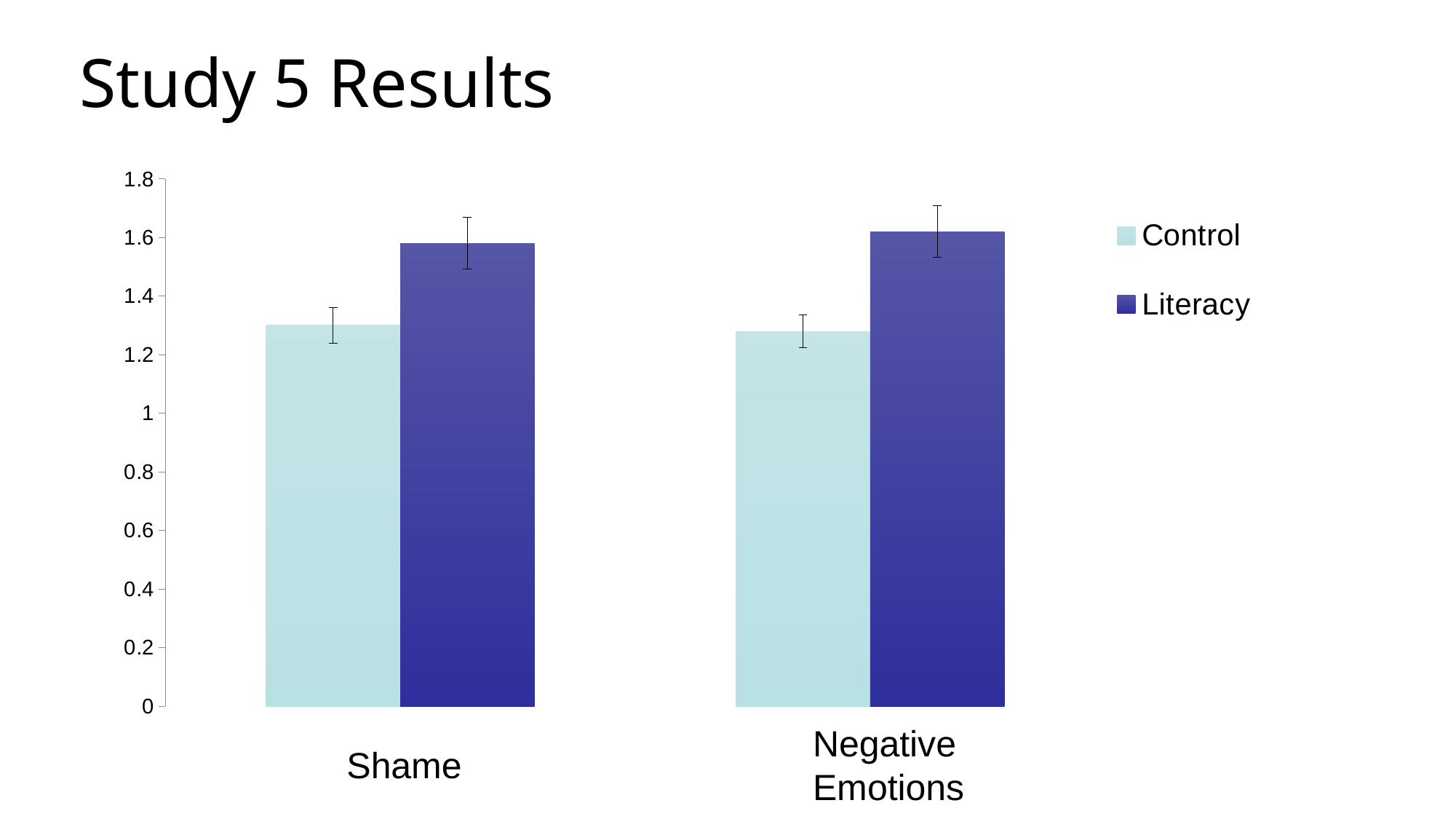
Which series has the larger value for Negative Emotions, Control or Literacy? Literacy How many series does the chart's legend list? 2 Which series has the larger value for Shame, Control or Literacy? Literacy What kind of chart is shown on the slide? bar chart What are the two series named in the chart's legend? Control and Literacy Is the Literacy value for Shame greater or less than 1.4? greater Is the Control value for Negative Emotions greater or less than 1.4? less Is the Control value for Shame greater or less than 1.4? less What is the title of the slide containing the chart? Study 5 Results How many categories are shown on the x axis of the chart? 2